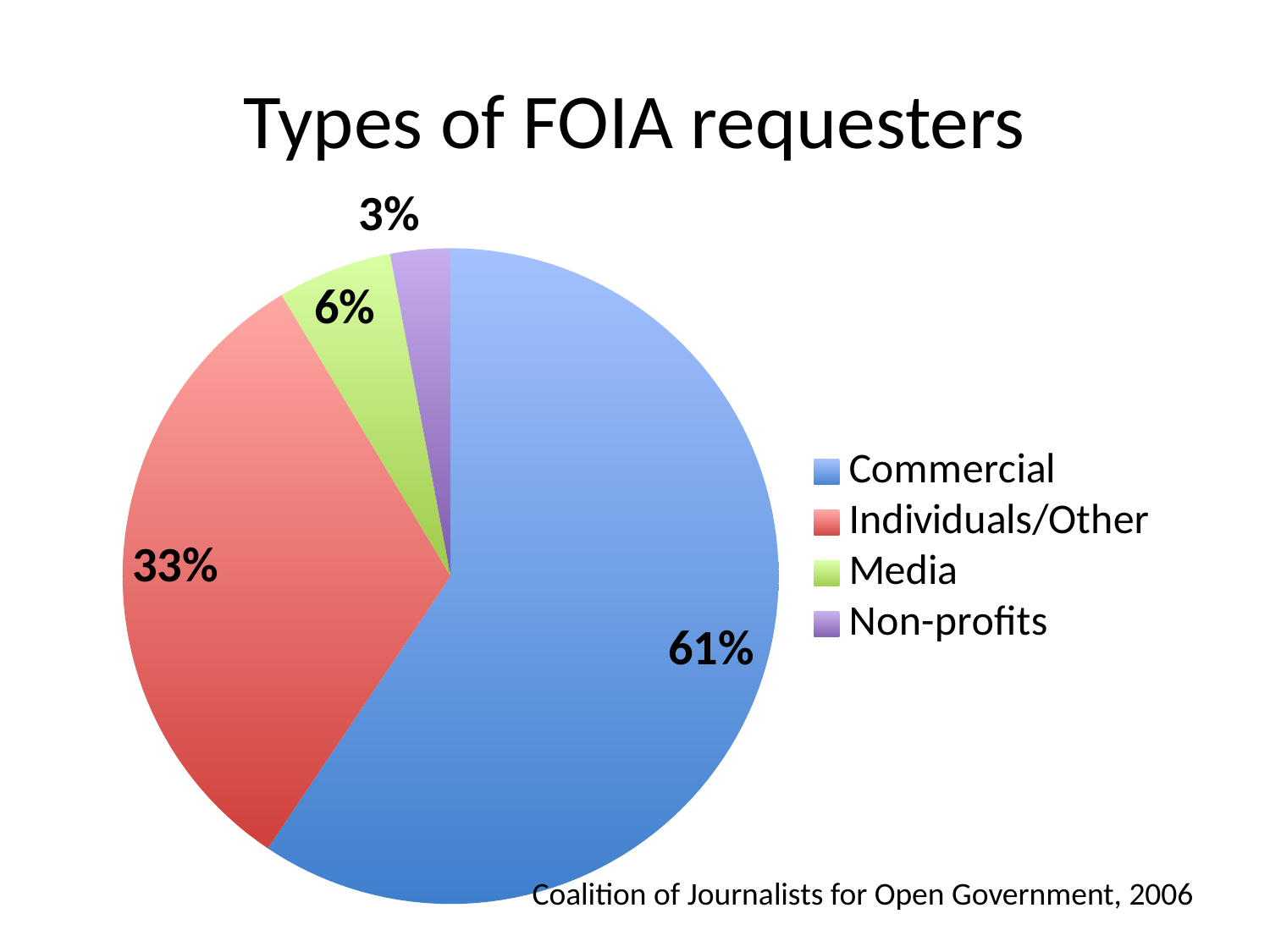
What percentage of FOIA requesters are Media? 6% Which category has the largest share of the pie? Commercial What percentage of FOIA requesters are Commercial? 61% Which category has the smallest share of the pie? Non-profits Which is larger, the Media share or the Non-profits share? Media What percentage of FOIA requesters are Non-profits? 3% What type of chart is shown on the slide? pie chart What is the title of the chart? Types of FOIA requesters What percentage of FOIA requesters are Individuals/Other? 33% How many categories does the legend list? 4 What is the difference in percentage points between Commercial and Individuals/Other? 28 What colour represents Individuals/Other in the chart? red